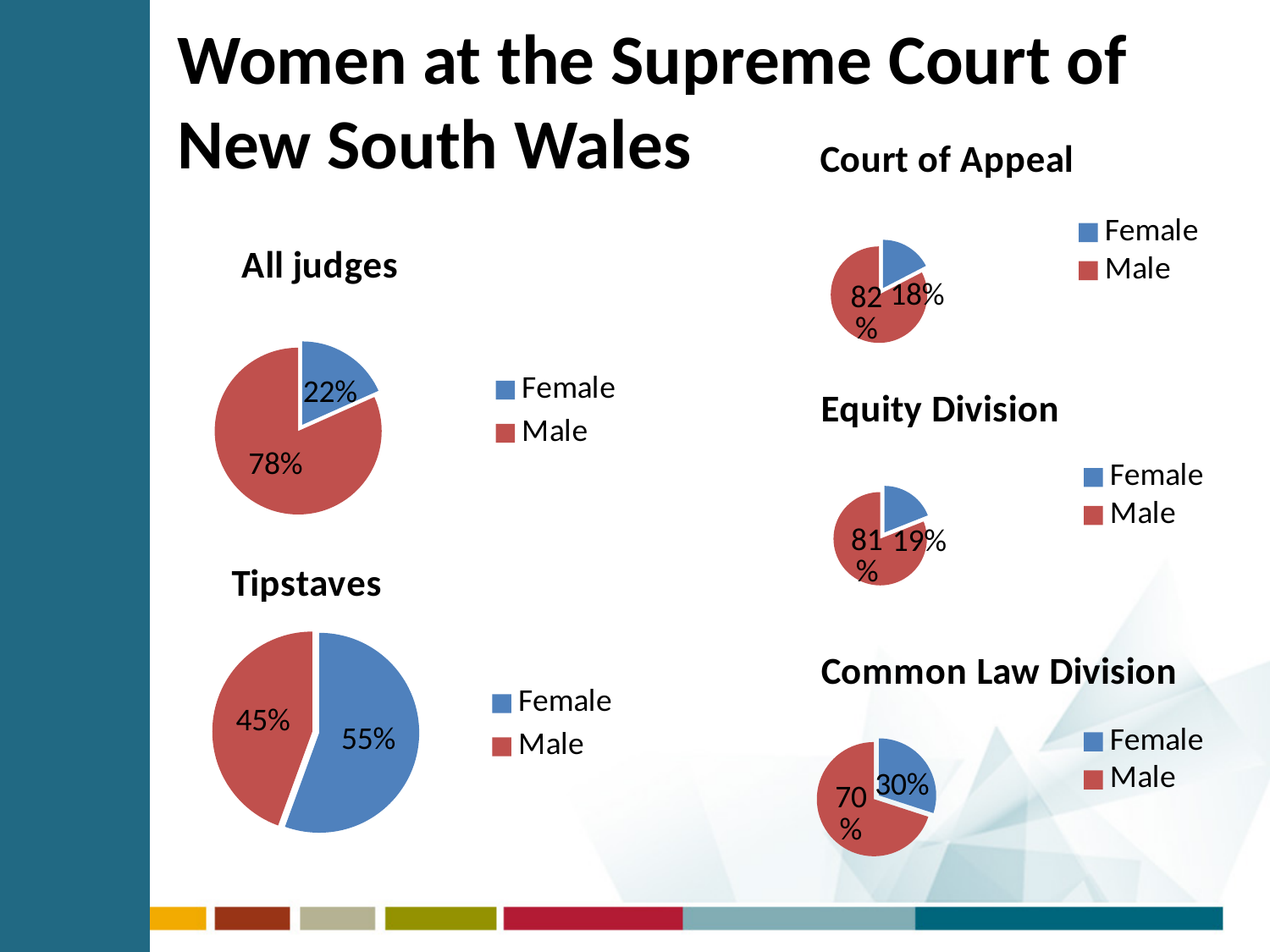
In the 'Tipstaves' chart, which slice is larger, Female or Male? Female In the 'Tipstaves' chart, what percentage is Female? 55% What kind of chart is the 'Common Law Division' chart? Pie chart In the 'Common Law Division' chart, what percentage is Female? 30% In the 'Tipstaves' chart, what percentage is Male? 45% How many pie charts are shown on the slide? 5 In the 'All judges' chart, what percentage is Male? 78% In the 'Court of Appeal' chart, what percentage is Female? 18% In the 'All judges' chart, what is the difference between the Male and Female percentages? 56% In the 'All judges' chart, what percentage is Female? 22% How many series does the legend of the 'Equity Division' chart list? 2 In the 'Equity Division' chart, what percentage is Male? 81%